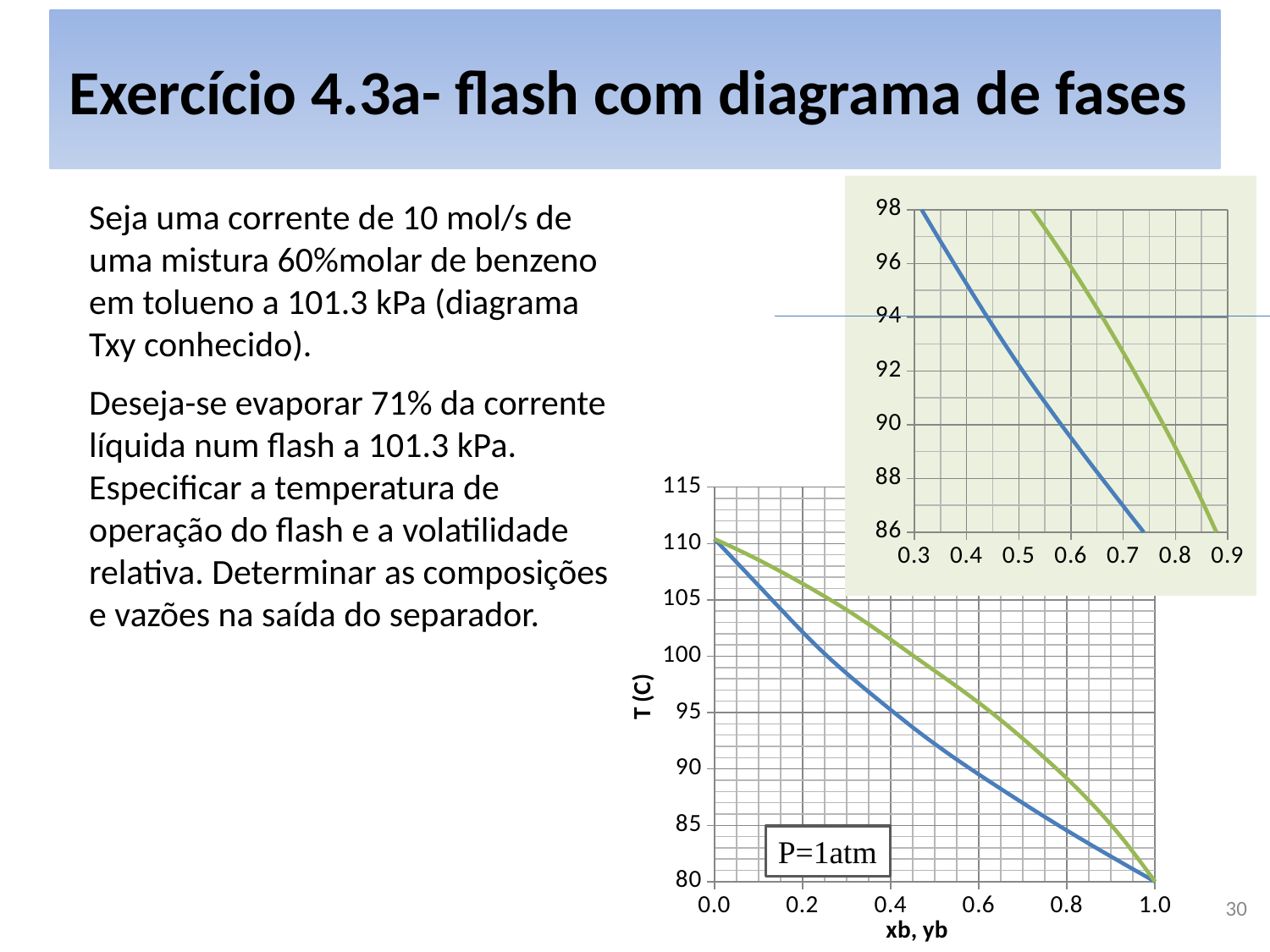
In the large chart at the bottom right, is the value of the blue curve at xb, yb = 0.6 greater or less than 95? less In the inset chart at the top right, do the curves rise or fall as the x value increases from 0.3 to 0.9? fall In the large chart at the bottom right, what is the label of the y axis? T (C) In the large chart at the bottom right, at xb, yb = 0.5, which curve has the higher temperature, the blue one or the green one? the green one In the large chart at the bottom right, what is the highest value shown on the T (C) axis? 115 In the large chart at the bottom right, is the value of the blue curve at xb, yb = 0.2 greater or less than 100? greater In the inset chart at the top right, is the value of the blue curve at 0.7 greater or less than 88? less In the large chart at the bottom right, what is the label of the x axis? xb, yb What kind of chart is the large chart at the bottom right of the slide? line chart In the large chart at the bottom right, do the curves rise or fall as xb, yb increases from 0.0 to 1.0? fall